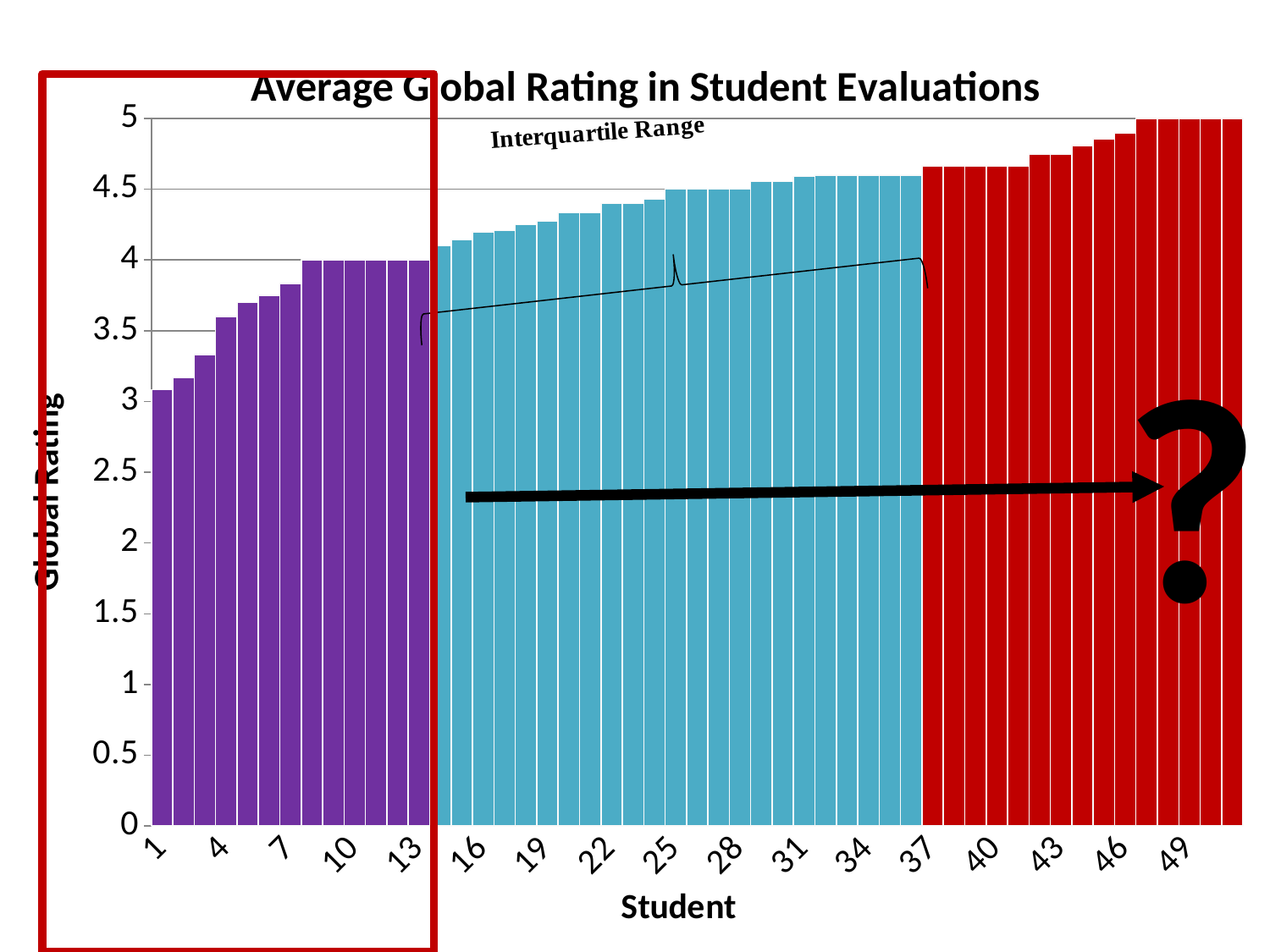
Do the bar values rise or fall as the student number increases along the x axis? rise Is the value for student 1 greater or less than 3.5? less Is the value for student 49 greater or less than 4.5? greater Which student has the lowest global rating? 1 Which has the larger value, student 1 or student 49? student 49 What is the label of the vertical axis? Global Rating Is the value for student 25 greater or less than 5? less What kind of chart is shown on the slide? bar chart What is the title of the chart? Average Global Rating in Student Evaluations